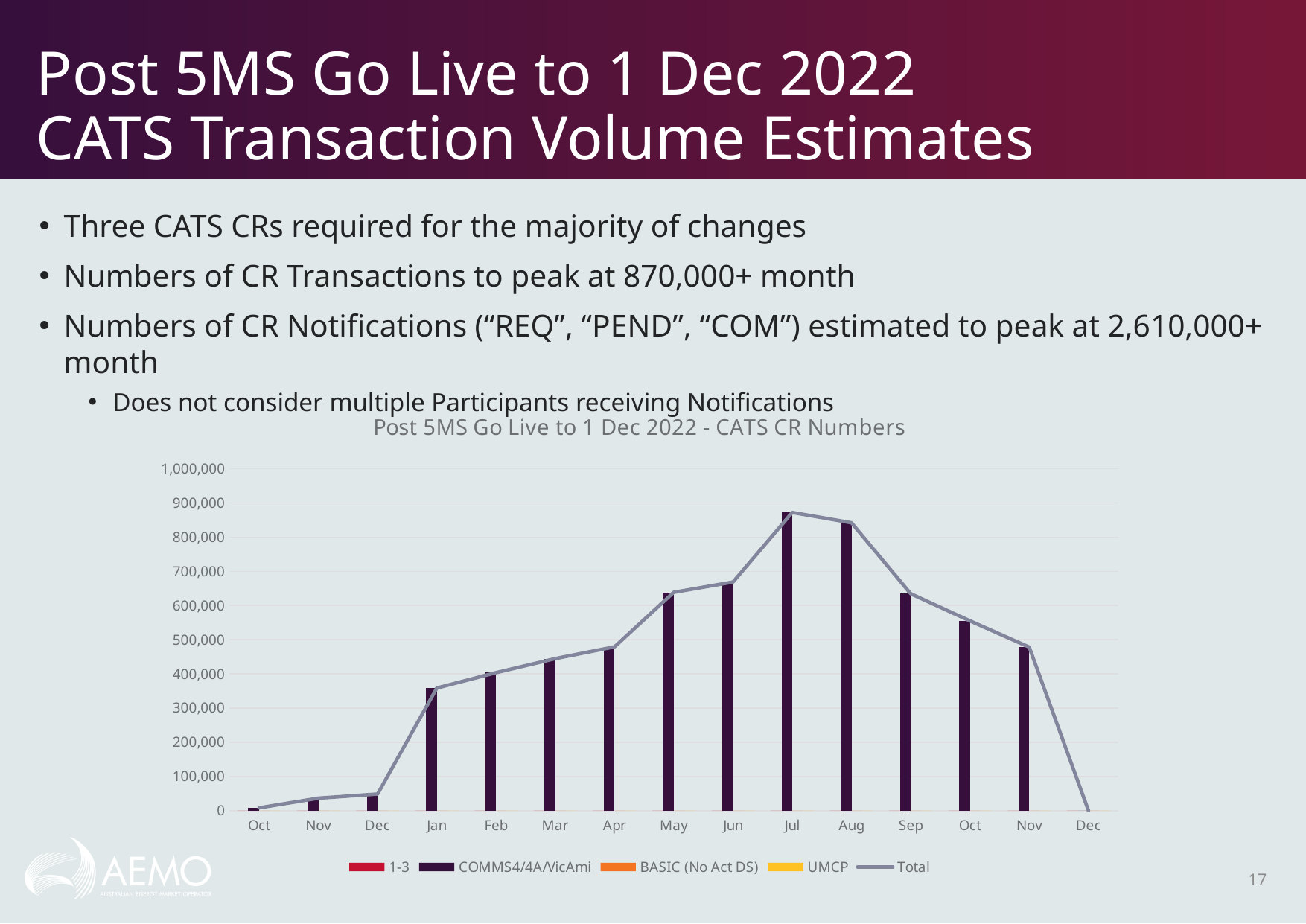
Which month has the larger Total value, Aug or Sep? Aug In which month does the Total line reach its highest value? Jul Does the Total line rise or fall from Aug to Nov? fall Is the Total value for Jan greater or less than 400,000? less Which month has the larger Total value, Feb or Apr? Apr Is the Total value for Jul greater or less than 800,000? greater Which series in the legend is drawn as a line rather than bars? Total How many months are shown along the x axis of the chart? 15 How many series does the chart legend list? 5 What is the title of the chart on the slide? Post 5MS Go Live to 1 Dec 2022 - CATS CR Numbers Is the Total value for May greater or less than 600,000? greater Does the Total line rise or fall from Jan to Jul? rise